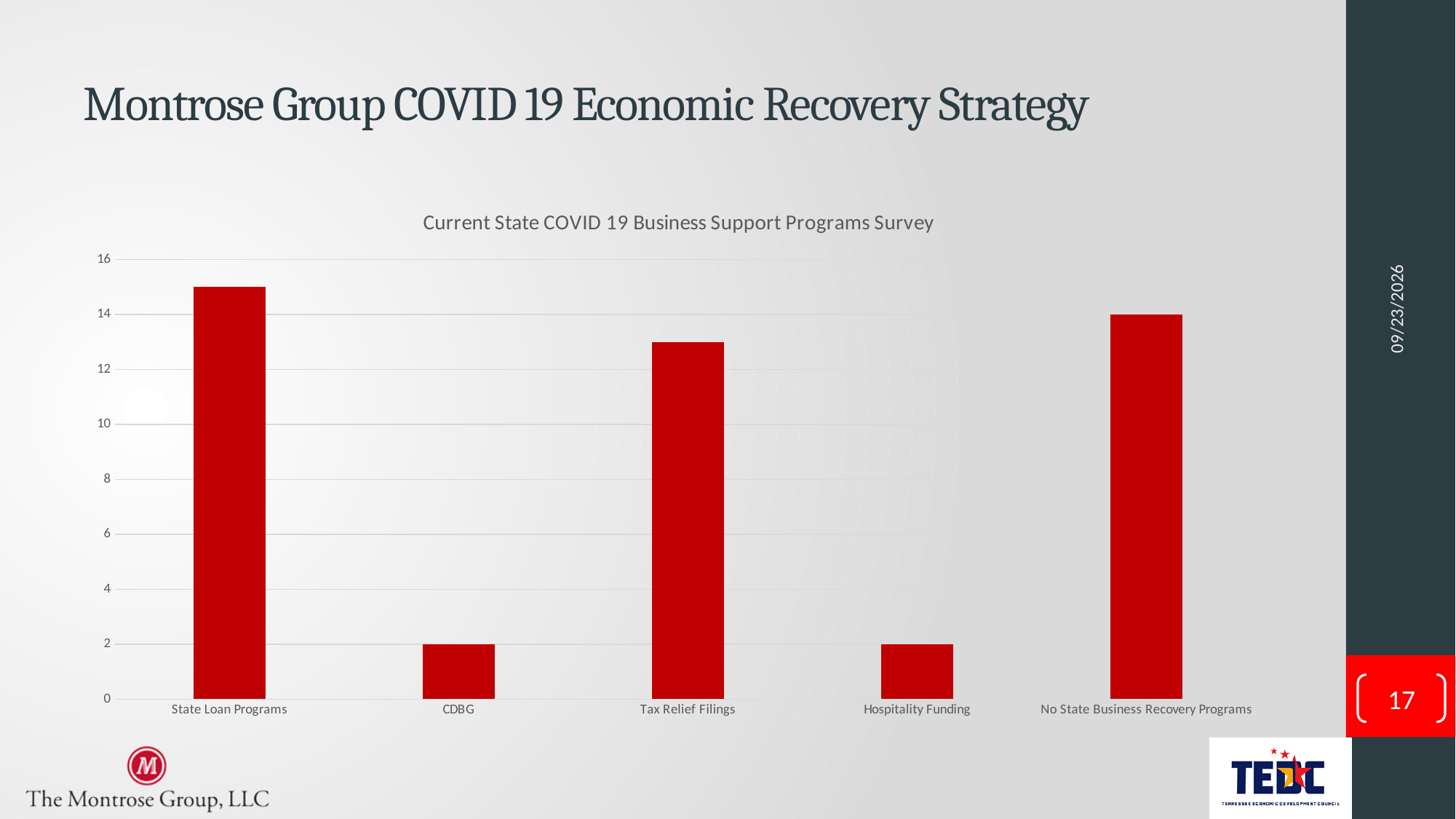
What is the value for CDBG? 2 What type of chart is shown on the slide? bar chart What colour are the bars in the chart? red Is the value for Tax Relief Filings greater or less than 14? less What is the title of the chart? Current State COVID 19 Business Support Programs Survey What is the value for Hospitality Funding? 2 What is the value for No State Business Recovery Programs? 14 Is the value for Tax Relief Filings greater or less than 12? greater Is the value for State Loan Programs greater or less than 14? greater How many categories are shown on the x axis of the chart? 5 Which is larger, the value for State Loan Programs or the value for Tax Relief Filings? State Loan Programs Which category has the highest value? State Loan Programs